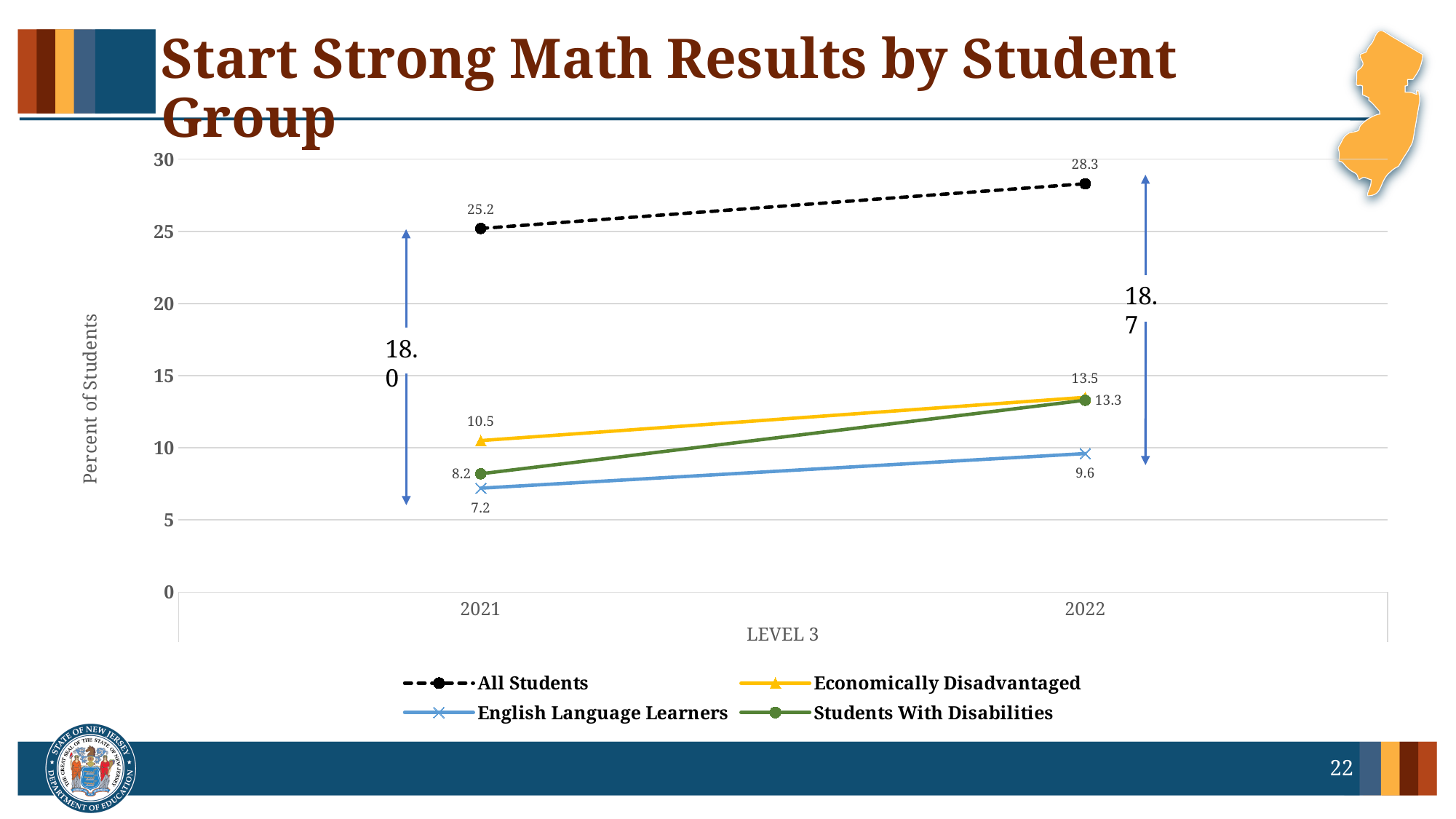
Does the value for Students With Disabilities rise or fall from 2021 to 2022? rise What is the difference between the All Students value and the English Language Learners value in 2021? 18.0 Which student group has the lowest value in 2021? English Language Learners What kind of chart is shown on the slide? line chart How many series does the legend list? 4 What is the value for Economically Disadvantaged in 2021? 10.5 What is the value for Students With Disabilities in 2022? 13.3 What is the value for English Language Learners in 2021? 7.2 Which is larger in 2021: the value for Students With Disabilities or the value for Economically Disadvantaged? Economically Disadvantaged What is the label on the vertical axis? Percent of Students Which student group has the highest value in 2022? All Students What is the value for All Students in 2022? 28.3